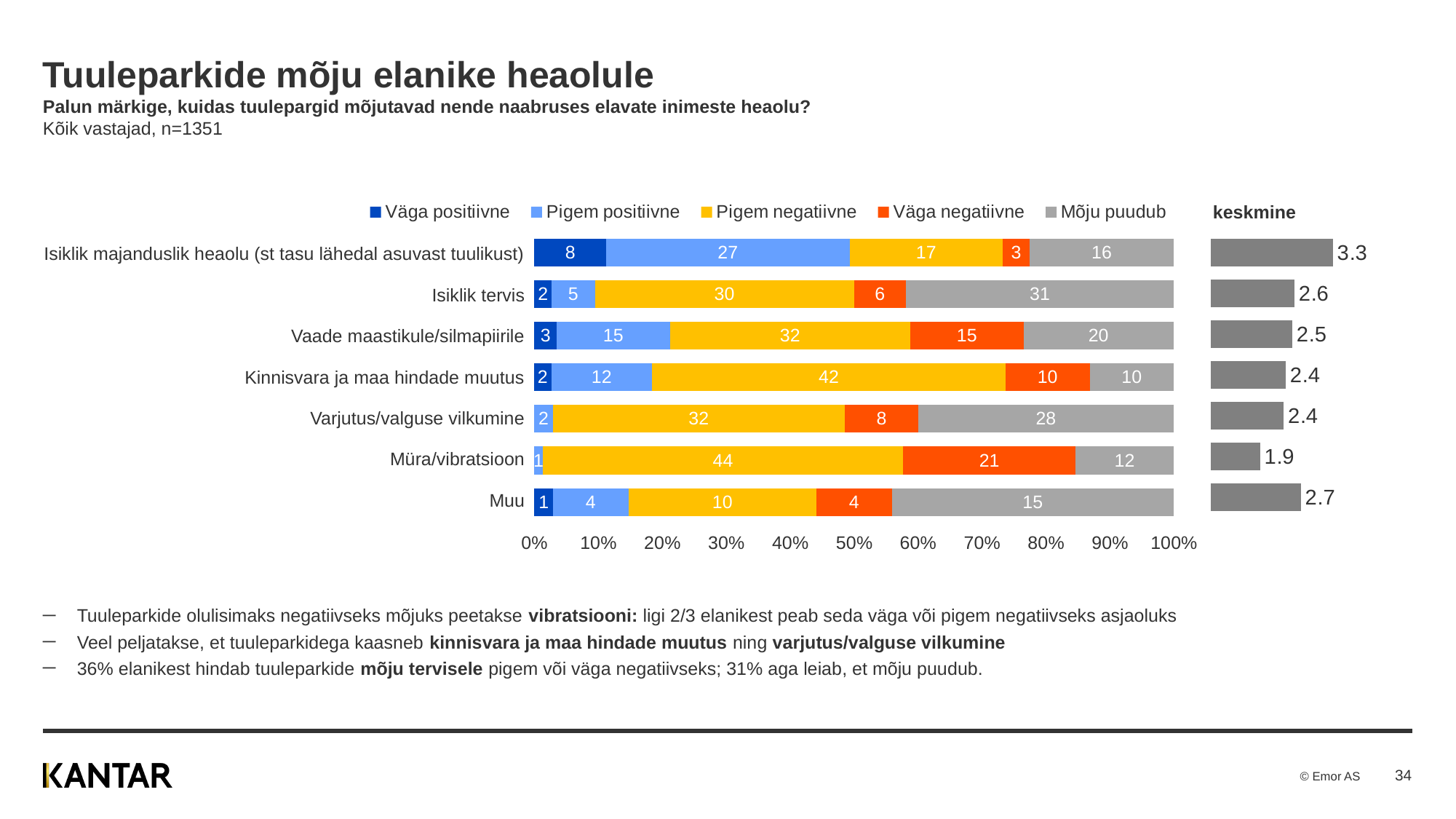
What is the total of the labelled segments in the Muu bar? 34 How many series does the legend list? 5 Which category has the lowest keskmine value? Müra/vibratsioon What kind of chart is used to show the responses? Stacked bar chart What is the value of "Pigem negatiivne" for Müra/vibratsioon? 44 How many categories are shown in the stacked bar chart? 7 What is the value of "Mõju puudub" for Isiklik tervis? 31 What is the value of "Väga negatiivne" for Vaade maastikule/silmapiirile? 15 What is the keskmine value for Isiklik majanduslik heaolu (st tasu lähedal asuvast tuulikust)? 3.3 What is the difference between the "Pigem negatiivne" values for Kinnisvara ja maa hindade muutus and Isiklik tervis? 12 Which category has the highest keskmine value? Isiklik majanduslik heaolu (st tasu lähedal asuvast tuulikust) Which has a larger "Väga negatiivne" value: Müra/vibratsioon or Vaade maastikule/silmapiirile? Müra/vibratsioon